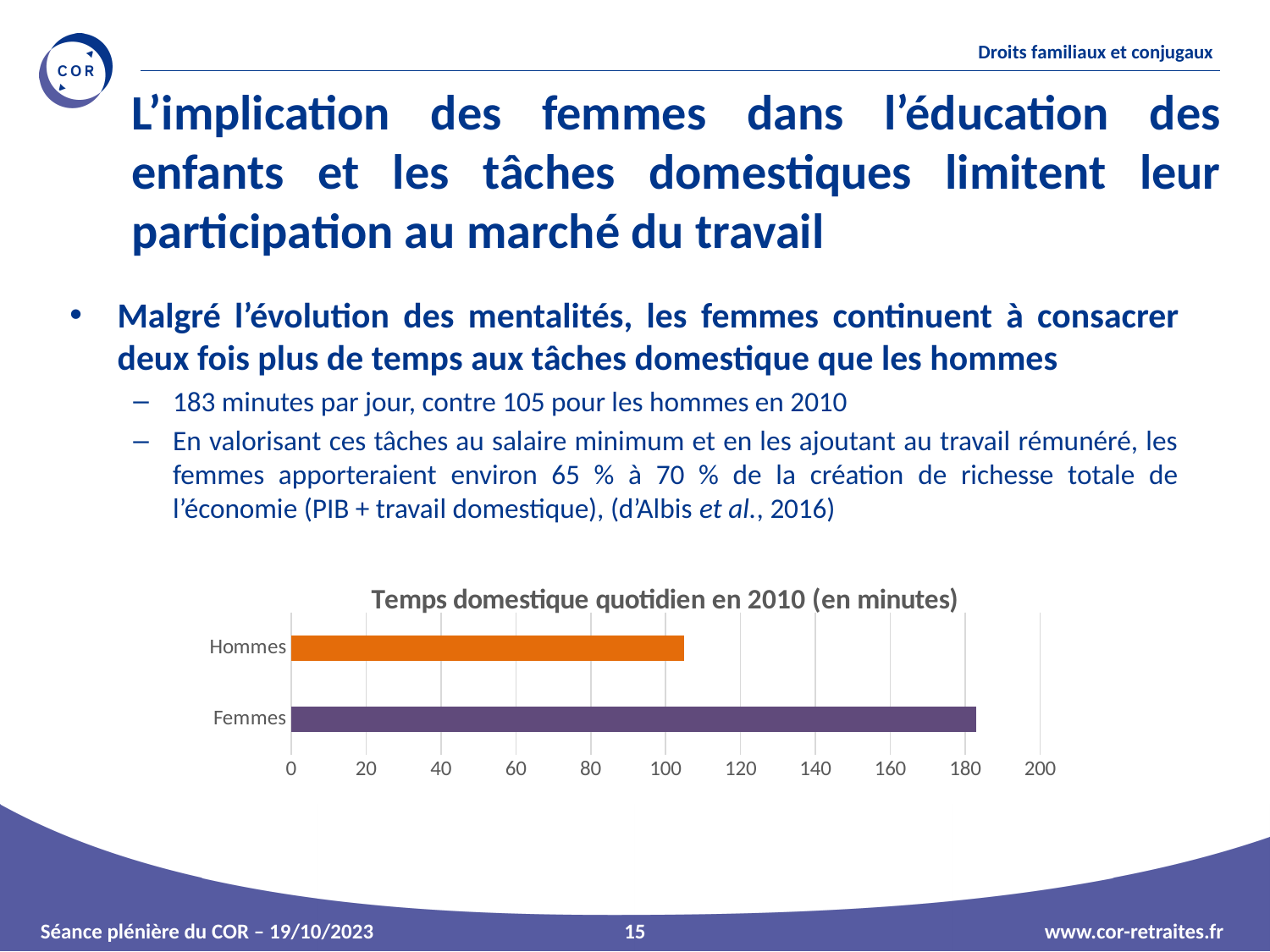
Which category has the highest value in the chart? Femmes Which category has the lowest value in the chart? Hommes What kind of chart is shown on the slide? bar chart What is the maximum value shown on the horizontal axis of the chart? 200 Is the value for Femmes greater or less than 160? greater Is the value for Femmes greater or less than 200? less Which is larger, the value for Femmes or the value for Hommes? Femmes What is the title of the chart? Temps domestique quotidien en 2010 (en minutes) Is the value for Hommes greater or less than 100? greater How many categories are shown in the chart? 2